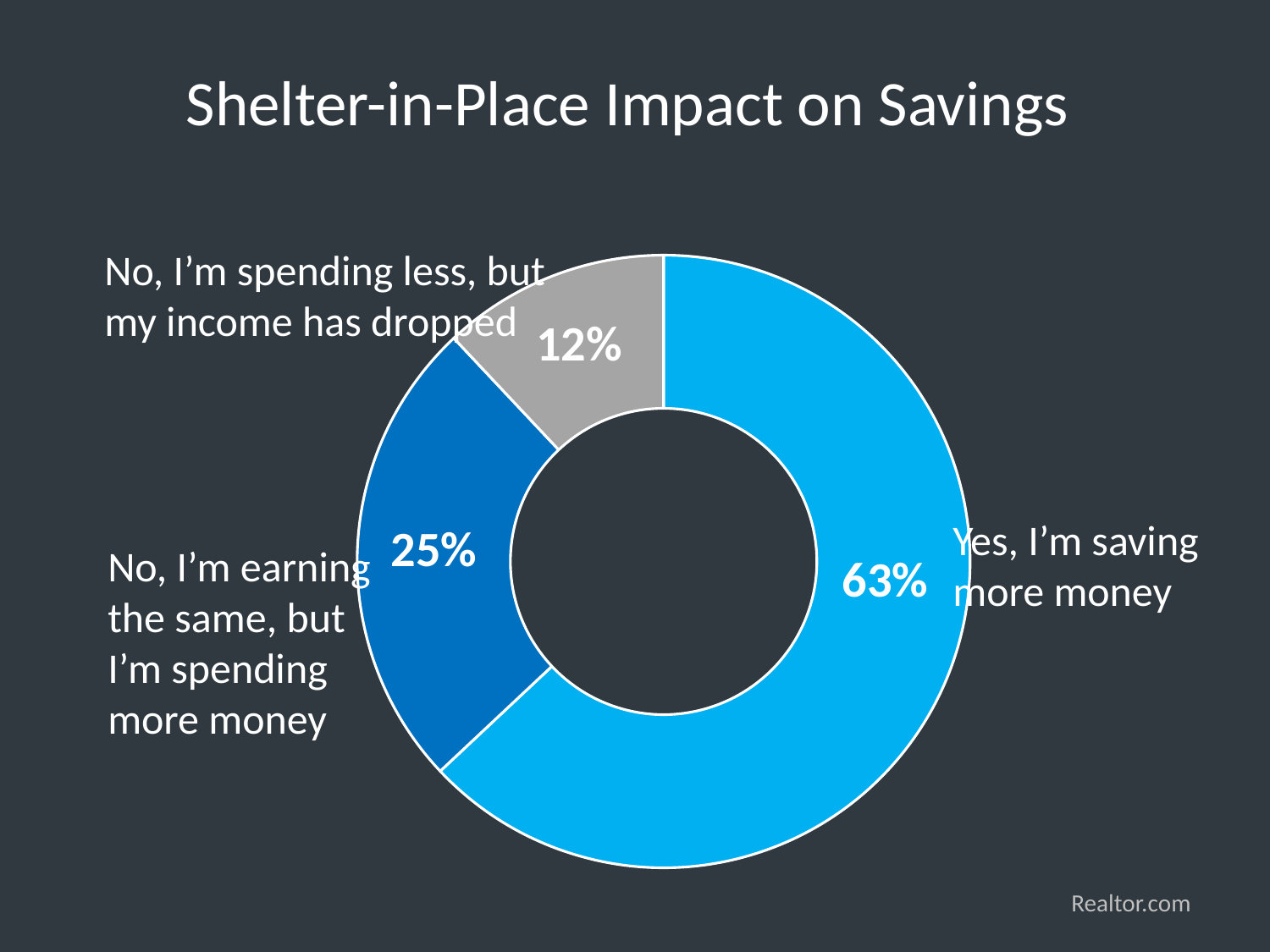
What colour is the slice for "No, I'm spending less, but my income has dropped"? Grey What is the difference in percentage points between "Yes, I'm saving more money" and "No, I'm earning the same, but I'm spending more money"? 38 Which is larger: the share for "No, I'm earning the same, but I'm spending more money" or the share for "No, I'm spending less, but my income has dropped"? No, I'm earning the same, but I'm spending more money Which response has the largest share of the chart? Yes, I'm saving more money What percentage of respondents said "Yes, I'm saving more money"? 63% What is the title of the chart? Shelter-in-Place Impact on Savings How many response categories are shown in the chart? 3 What kind of chart is shown on the slide? Pie chart (doughnut) Which response has the smallest share of the chart? No, I'm spending less, but my income has dropped What percentage of respondents said "No, I'm earning the same, but I'm spending more money"? 25% What is the difference in percentage points between "No, I'm earning the same, but I'm spending more money" and "No, I'm spending less, but my income has dropped"? 13 What percentage of respondents said "No, I'm spending less, but my income has dropped"? 12%